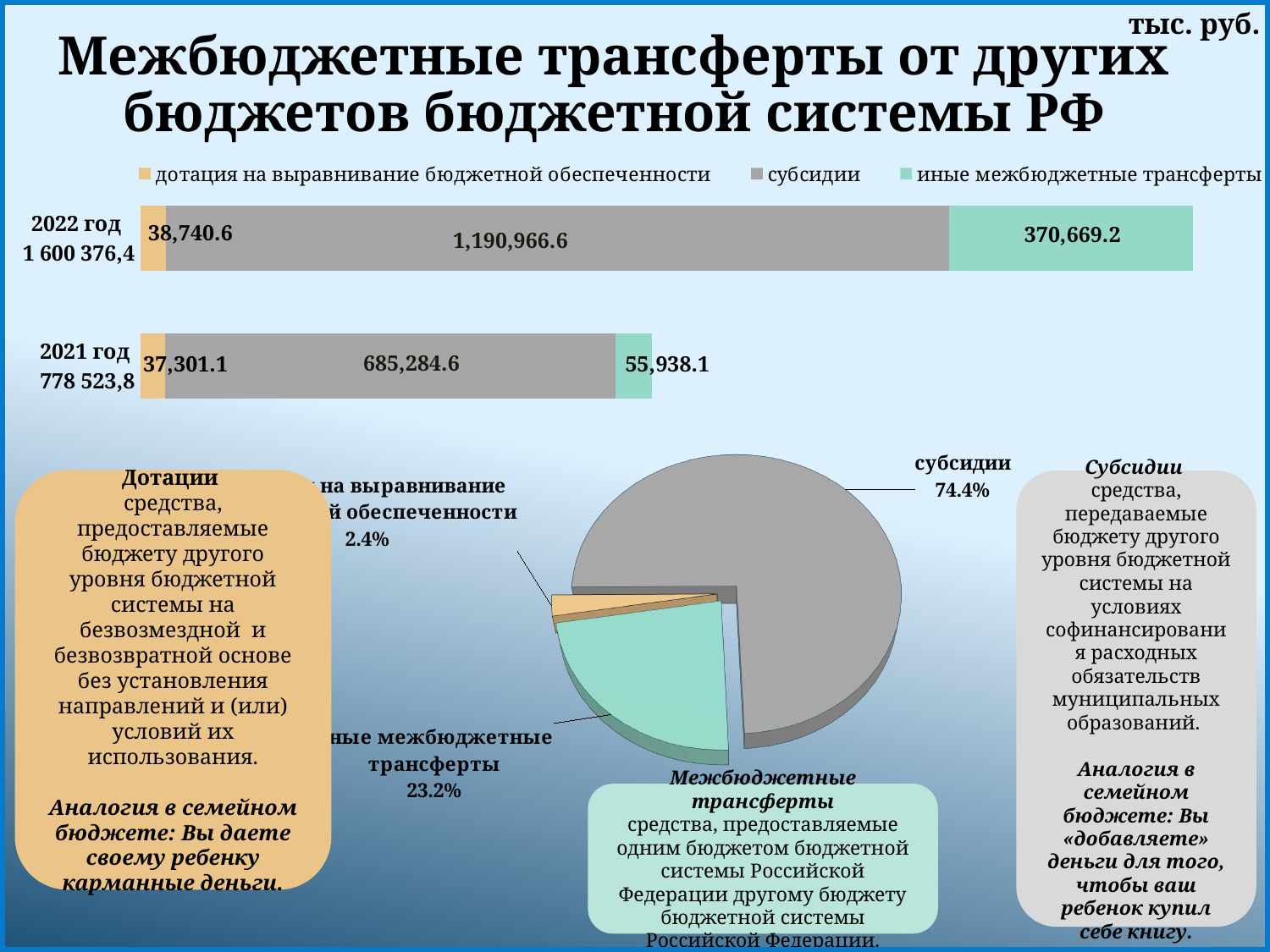
In the bottom pie chart, what share do иные межбюджетные трансферты have? 23.2% What kind of chart is the top chart on the slide? Stacked bar chart In the top bar chart, how many years are shown? 2 In the top bar chart, what is the value of субсидии for 2021 год? 685,284.6 In the top bar chart, what is the value of иные межбюджетные трансферты for 2021 год? 55,938.1 In the top bar chart, what is the difference between the субсидии values for 2022 год and 2021 год? 505,682.0 In the bottom pie chart, which slice is the smallest? дотация на выравнивание бюджетной обеспеченности In the top bar chart, what is the value of субсидии for 2022 год? 1,190,966.6 In the top bar chart, what is the value of дотация на выравнивание бюджетной обеспеченности for 2022 год? 38,740.6 In the top bar chart, how many series does the legend list? 3 In the bottom pie chart, what share does субсидии have? 74.4% In the top bar chart, which year has the larger value for иные межбюджетные трансферты, 2022 год or 2021 год? 2022 год